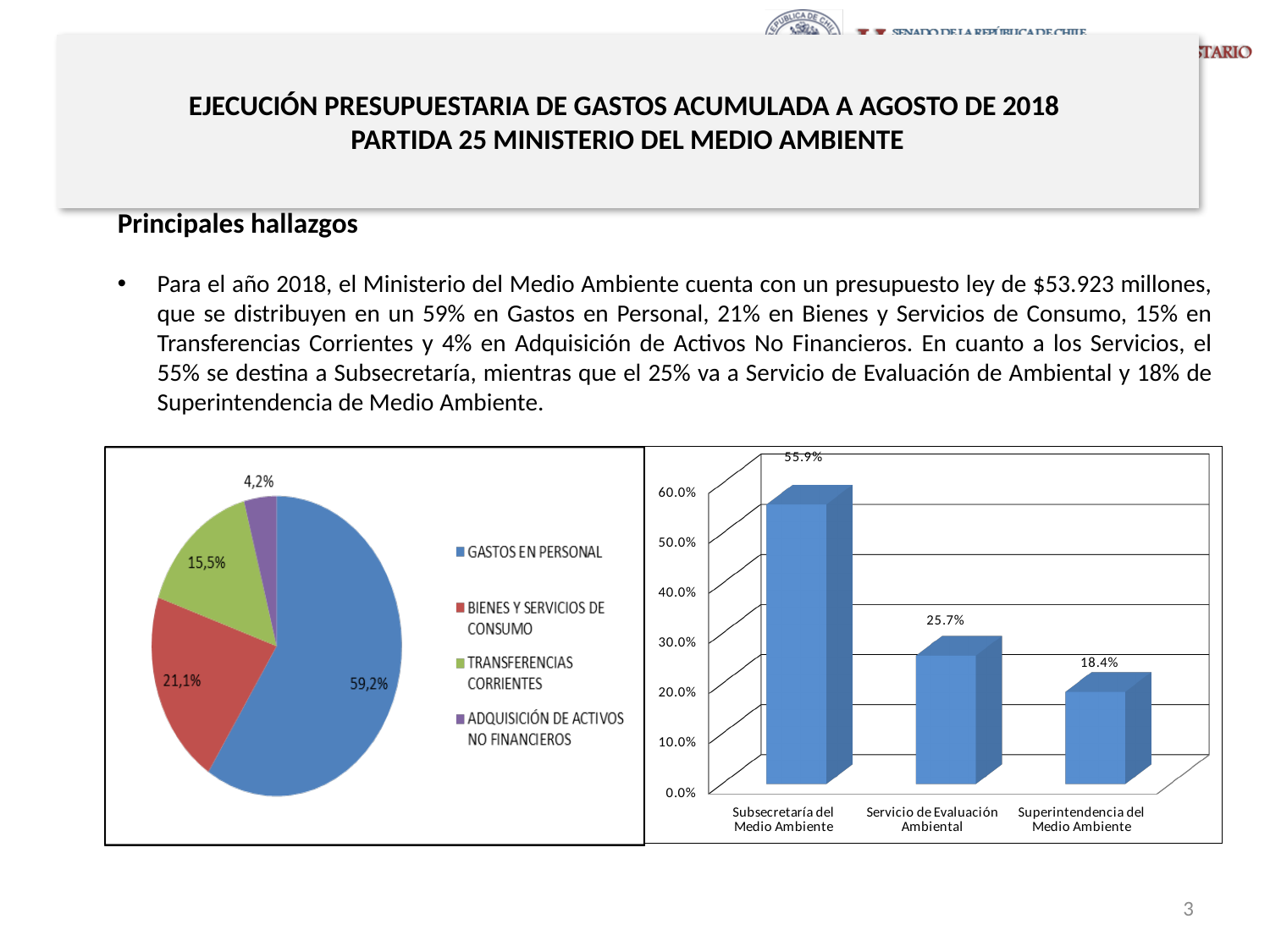
How many categories does the legend of the pie chart on the left list? 4 In the pie chart on the left, what share is shown for GASTOS EN PERSONAL? 59,2% In the pie chart on the left, which category has the smallest slice? ADQUISICIÓN DE ACTIVOS NO FINANCIEROS How many bars are shown in the bar chart on the right? 3 In the bar chart on the right, do the values rise or fall from left to right? Fall In the bar chart on the right, what is the value for Servicio de Evaluación Ambiental? 25.7% In the bar chart on the right, what is the value for Superintendencia del Medio Ambiente? 18.4% In the bar chart on the right, what is the difference between the values for Subsecretaría del Medio Ambiente and Servicio de Evaluación Ambiental? 30.2% What kind of chart is the chart on the left of the slide? Pie chart In the pie chart on the left, what share is shown for TRANSFERENCIAS CORRIENTES? 15,5% In the bar chart on the right, which category has the highest value? Subsecretaría del Medio Ambiente In the pie chart on the left, which category has the largest slice? GASTOS EN PERSONAL